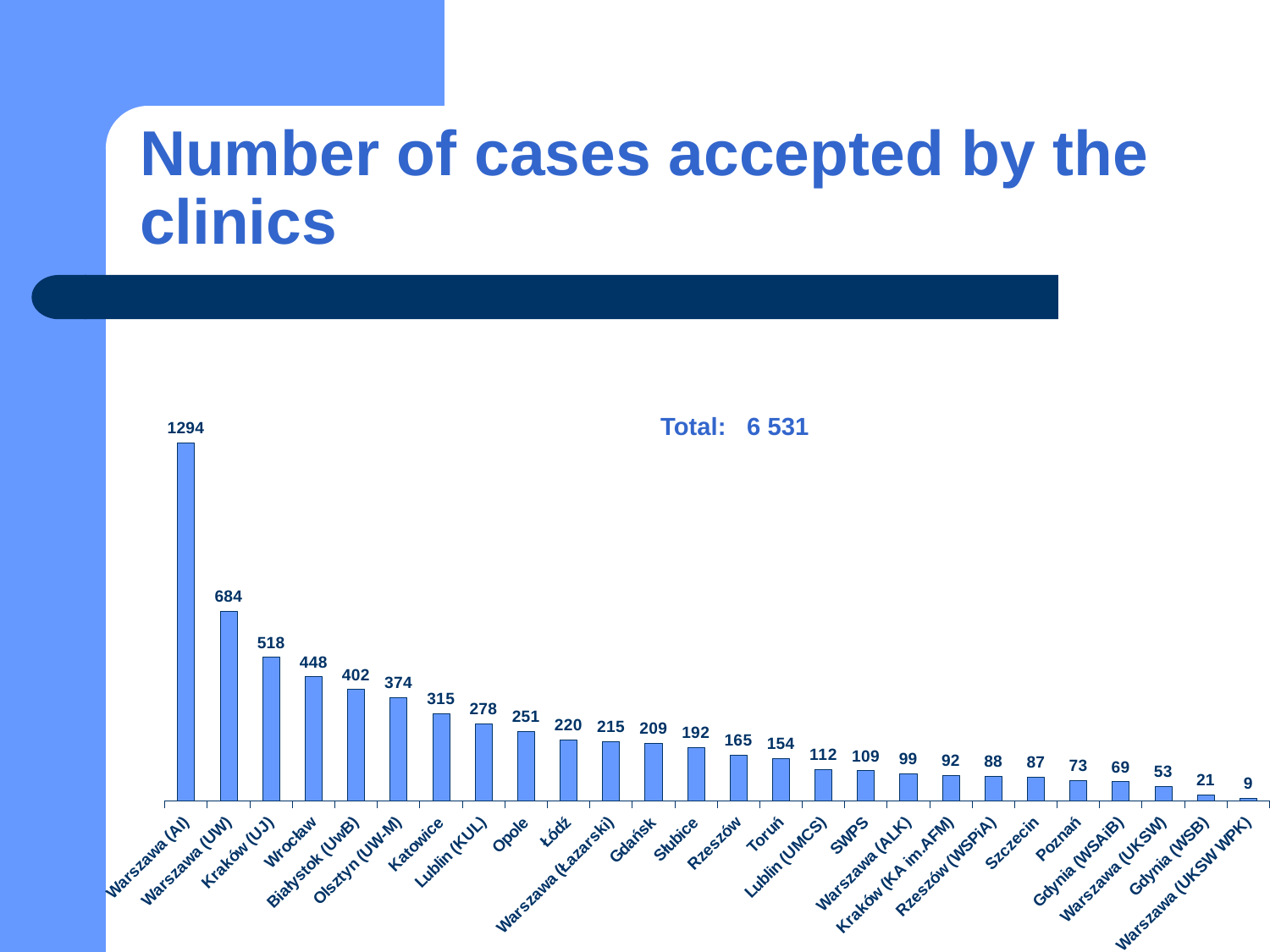
What type of chart is used on the slide? Bar chart Which clinic accepted more cases, Lublin (KUL) or Opole? Lublin (KUL) What is the difference between the cases accepted by Kraków (UJ) and Wrocław? 70 How many cases were accepted by the Warszawa (UW) clinic? 684 What total number of cases is stated on the chart? 6 531 How many clinics are shown in the chart? 26 Which clinic accepted the highest number of cases? Warszawa (AI) What is the difference between the number of cases for Warszawa (AI) and Warszawa (UW)? 610 Which clinic accepted more cases, Gdynia (WSB) or Warszawa (UKSW)? Warszawa (UKSW) Which clinic accepted the lowest number of cases? Warszawa (UKSW WPK) How many cases did the Szczecin clinic accept? 87 What is the number of cases for Katowice? 315